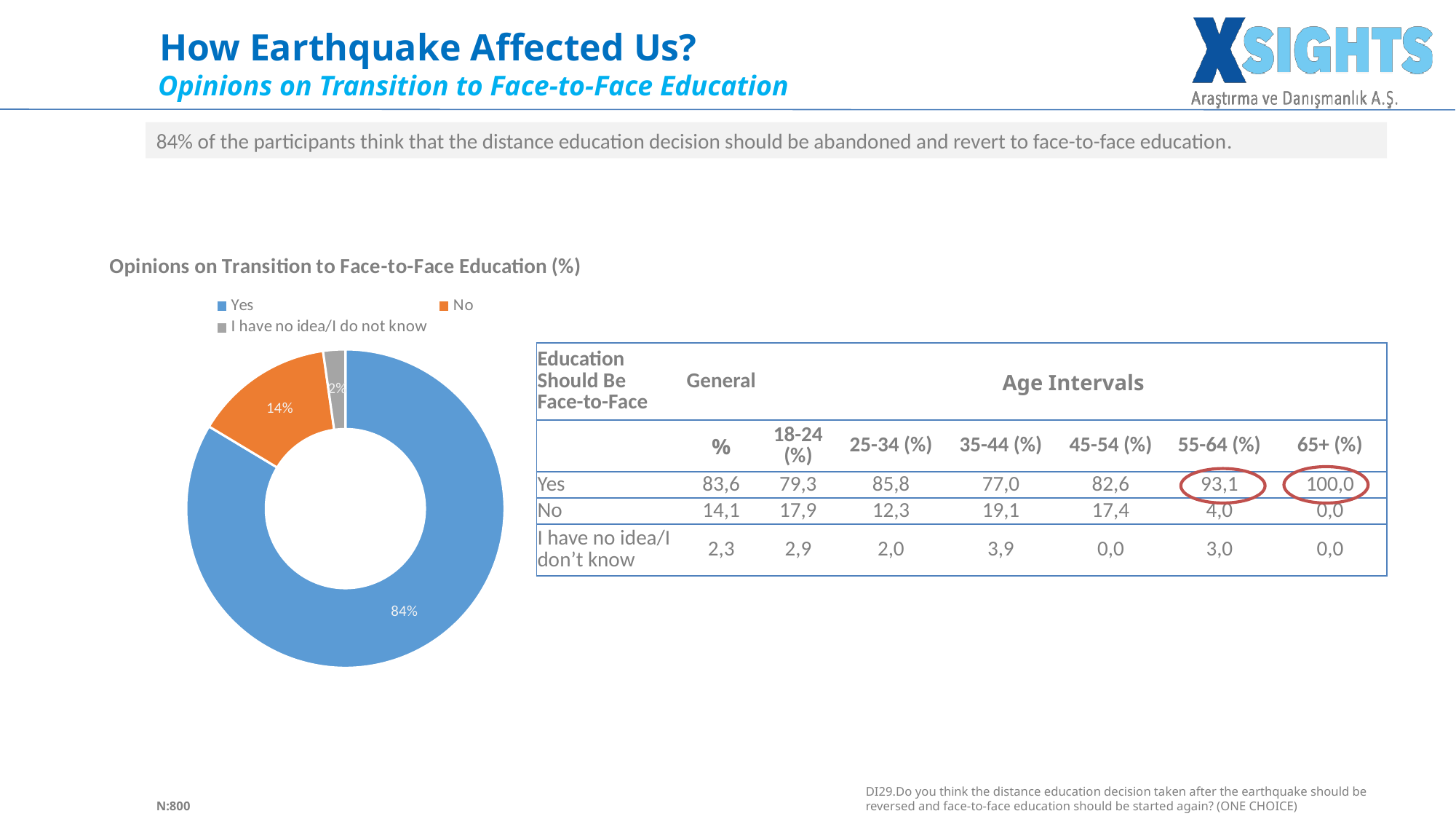
What kind of chart is shown on the slide? doughnut chart What is the value for Yes in the doughnut chart? 84% What colour is the No slice in the doughnut chart? orange Which category has the smallest slice in the doughnut chart? I have no idea/I do not know Which category has the largest slice in the doughnut chart? Yes Which is larger in the doughnut chart, No or 'I have no idea/I do not know'? No What is the difference between the Yes and No values in the doughnut chart? 70% How many entries does the legend of the doughnut chart list? 3 What is the title of the doughnut chart? Opinions on Transition to Face-to-Face Education (%) What is the value for No in the doughnut chart? 14% What is the value for 'I have no idea/I do not know' in the doughnut chart? 2% How many categories does the doughnut chart show? 3